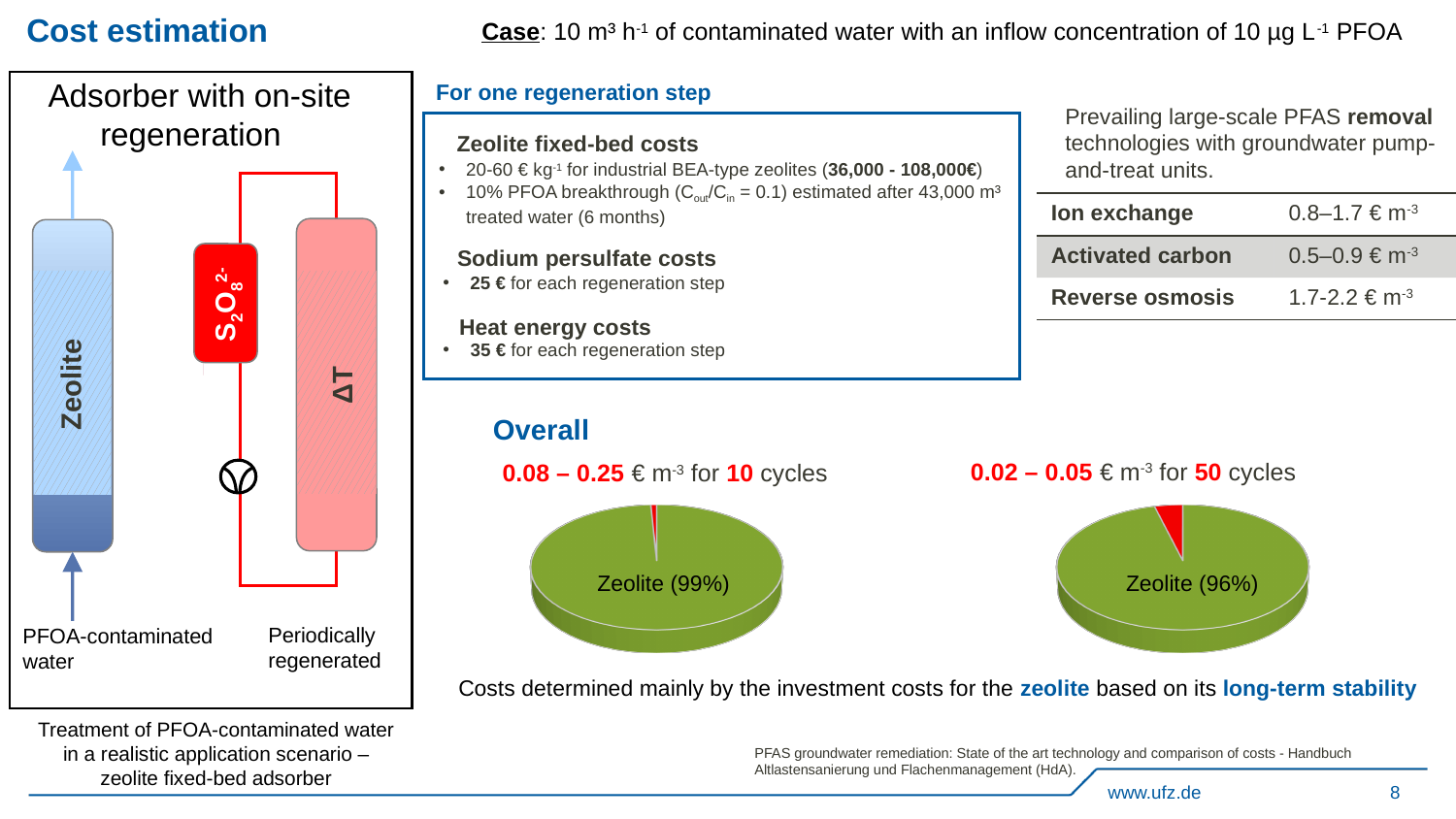
How many pie charts are shown on the slide? 2 What colour is the Zeolite slice in the pie charts? green In the pie chart for 50 cycles, what share is labelled for Zeolite? 96% In the pie chart for 50 cycles, which slice is the largest? Zeolite By how many percentage points does the Zeolite share in the 10-cycle pie chart exceed the Zeolite share in the 50-cycle pie chart? 3 percentage points Which pie chart shows the larger share for Zeolite, the one for 10 cycles or the one for 50 cycles? 10 cycles In the pie chart for 10 cycles, what share is labelled for Zeolite? 99% What kind of chart is used under the 'Overall' heading to show the cost breakdown for 10 cycles? pie chart How many slices does the pie chart for 10 cycles contain? 2 What colour is the small unlabelled slice in the pie chart for 50 cycles? red